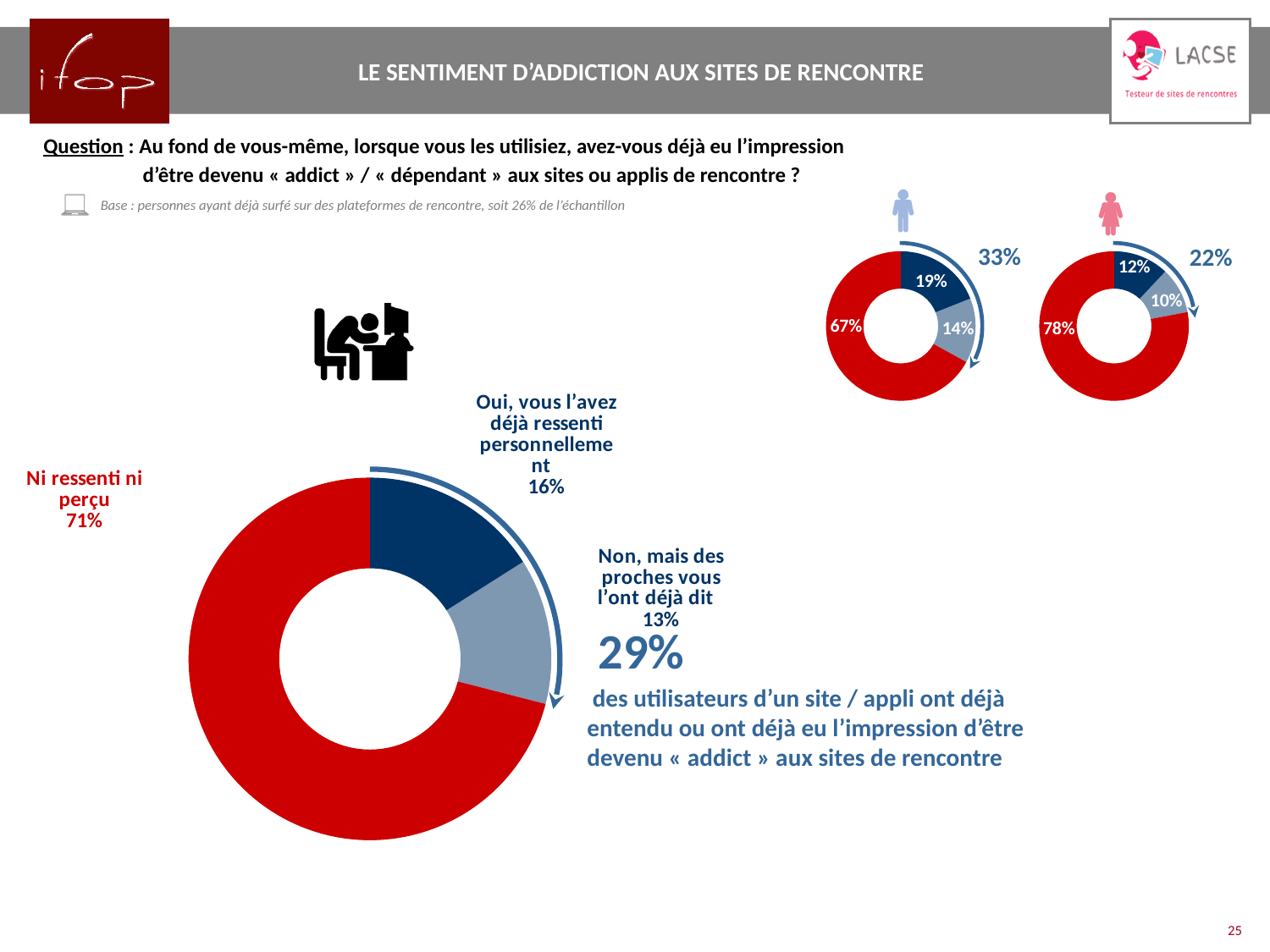
How many categories does the large donut chart show? 3 On the large donut chart, which category has the smallest share? Non, mais des proches vous l'ont déjà dit On the large donut chart, which category has the largest share? Ni ressenti ni perçu On the small donut chart for men (left of the two small charts), what is the largest segment's value? 67% On the large donut chart, what is the difference between "Ni ressenti ni perçu" and "Oui, vous l'avez déjà ressenti personnellement"? 55 percentage points On the large donut chart, what percentage is shown for "Oui, vous l'avez déjà ressenti personnellement"? 16% On the large donut chart, what percentage is shown for "Non, mais des proches vous l'ont déjà dit"? 13% Which is larger: the combined "addict" share for men (33%) or for women (22%)? Men (33%) On the small donut chart for women, what is the difference between the 12% segment and the 10% segment? 2 percentage points What kind of chart is the large chart on the left of the slide? Donut (pie) chart On the large donut chart, what percentage is shown for "Ni ressenti ni perçu"? 71% On the small donut chart for women (right of the two small charts), what is the largest segment's value? 78%